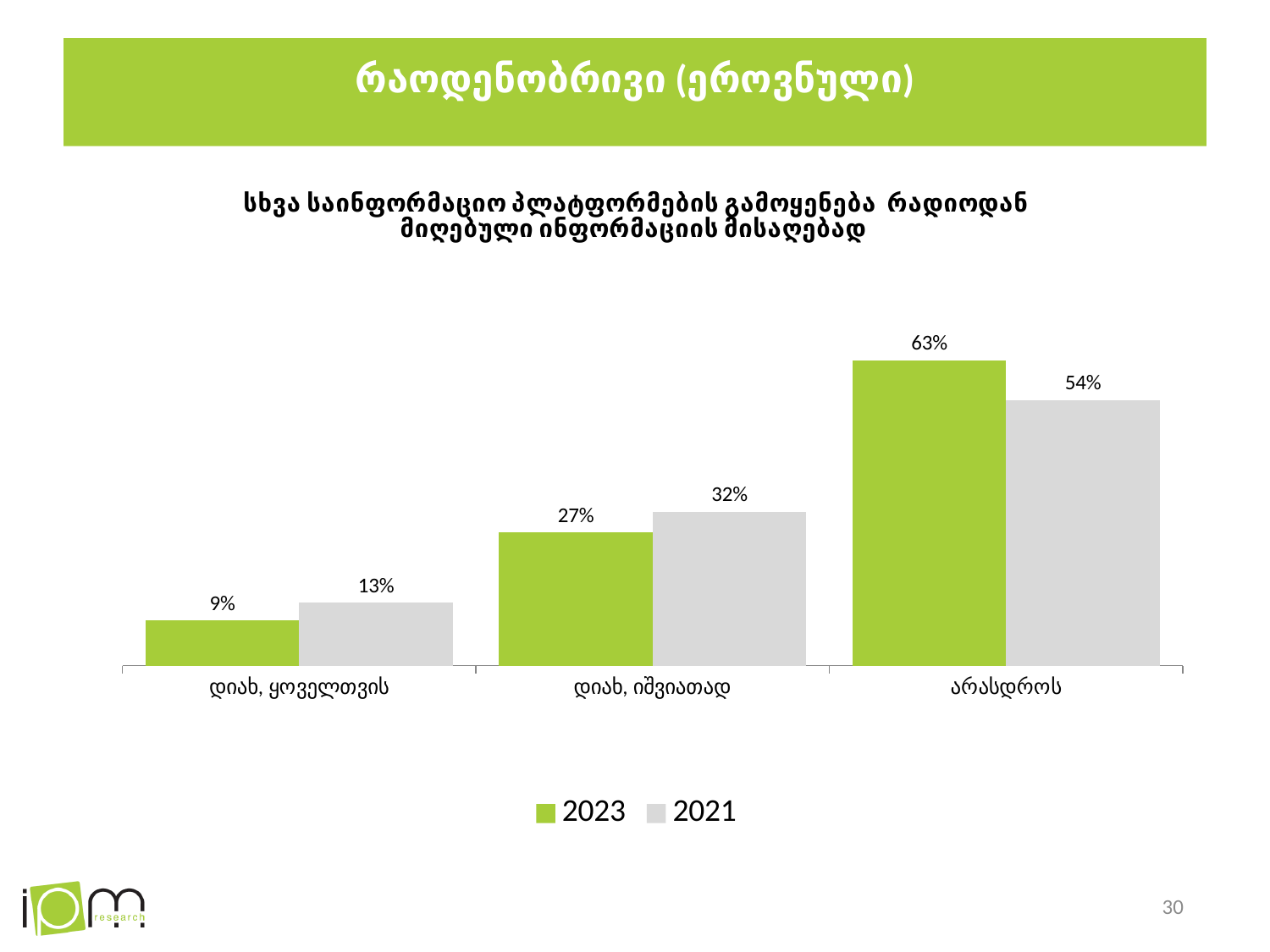
Which category has the lowest value for 2021? დიახ, ყოველთვის What is the value for 2021 in the category "არასდროს"? 54% How many series does the legend list? 2 Which category has the highest value for 2023? არასდროს Which colour represents the 2023 series in the chart? Green What is the value for 2023 in the category "დიახ, ყოველთვის"? 9% How many categories are shown on the x axis of the chart? 3 What is the difference between the 2023 and 2021 values in the category "არასდროს"? 9% What kind of chart is shown on the slide? Bar chart In the category "დიახ, ყოველთვის", which series has the larger value, 2023 or 2021? 2021 What is the value for 2021 in the category "დიახ, იშვიათად"? 32% What is the difference between the 2021 and 2023 values in the category "დიახ, იშვიათად"? 5%